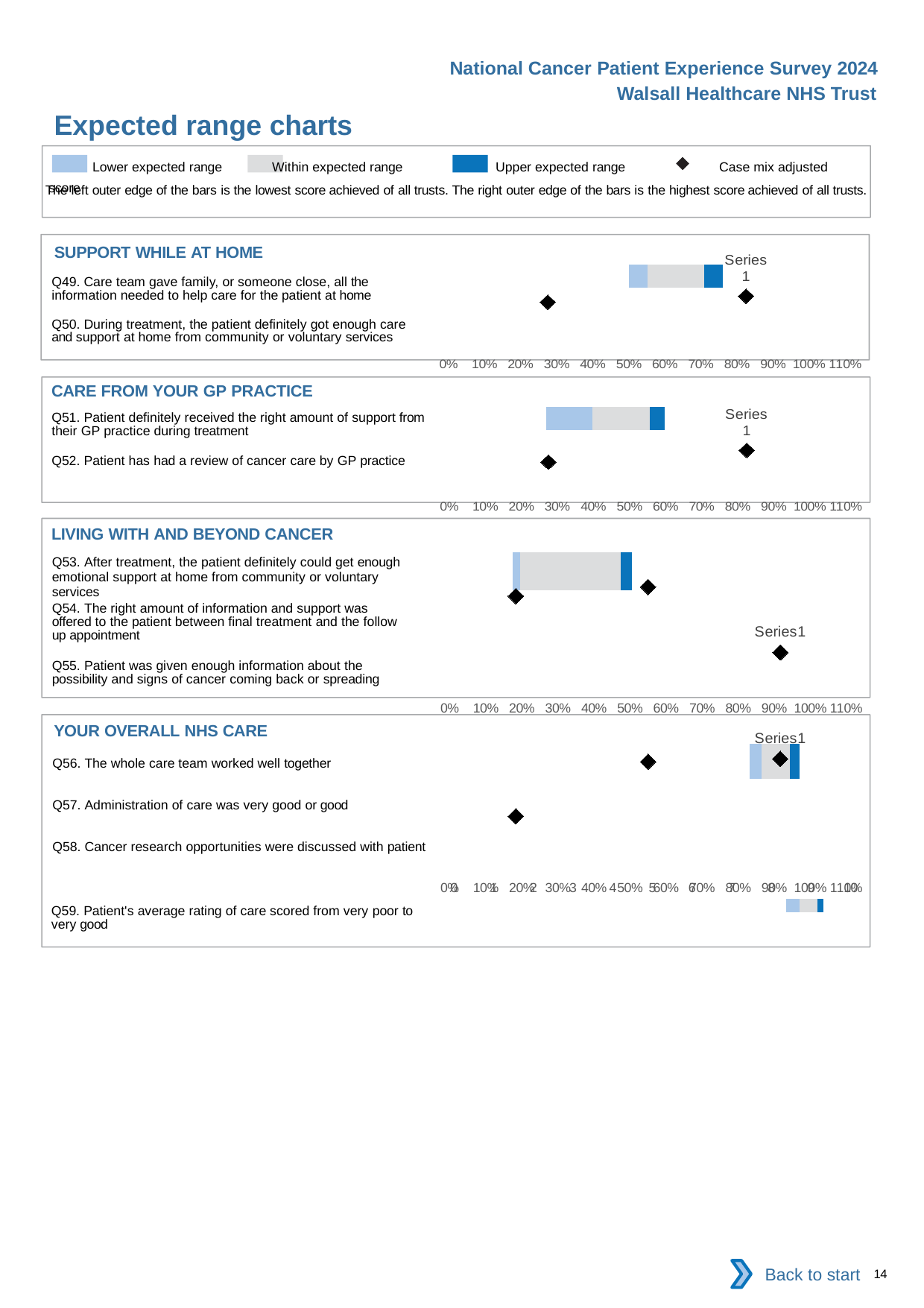
In the SUPPORT WHILE AT HOME chart, is the leftmost diamond marker greater or less than 50%? less What kind of chart is used in the SUPPORT WHILE AT HOME section? bar chart According to the legend, what does the black diamond marker represent? Case mix adjusted score In the CARE FROM YOUR GP PRACTICE chart, is the leftmost diamond marker greater or less than 40%? less In the SUPPORT WHILE AT HOME chart, is the rightmost diamond marker greater or less than 70%? greater How many questions are listed in the YOUR OVERALL NHS CARE chart? 4 How many entries does the legend at the top of the slide list? 4 How many questions are listed in the LIVING WITH AND BEYOND CANCER chart? 3 What is the highest tick label shown on the x axis of the CARE FROM YOUR GP PRACTICE chart? 110%